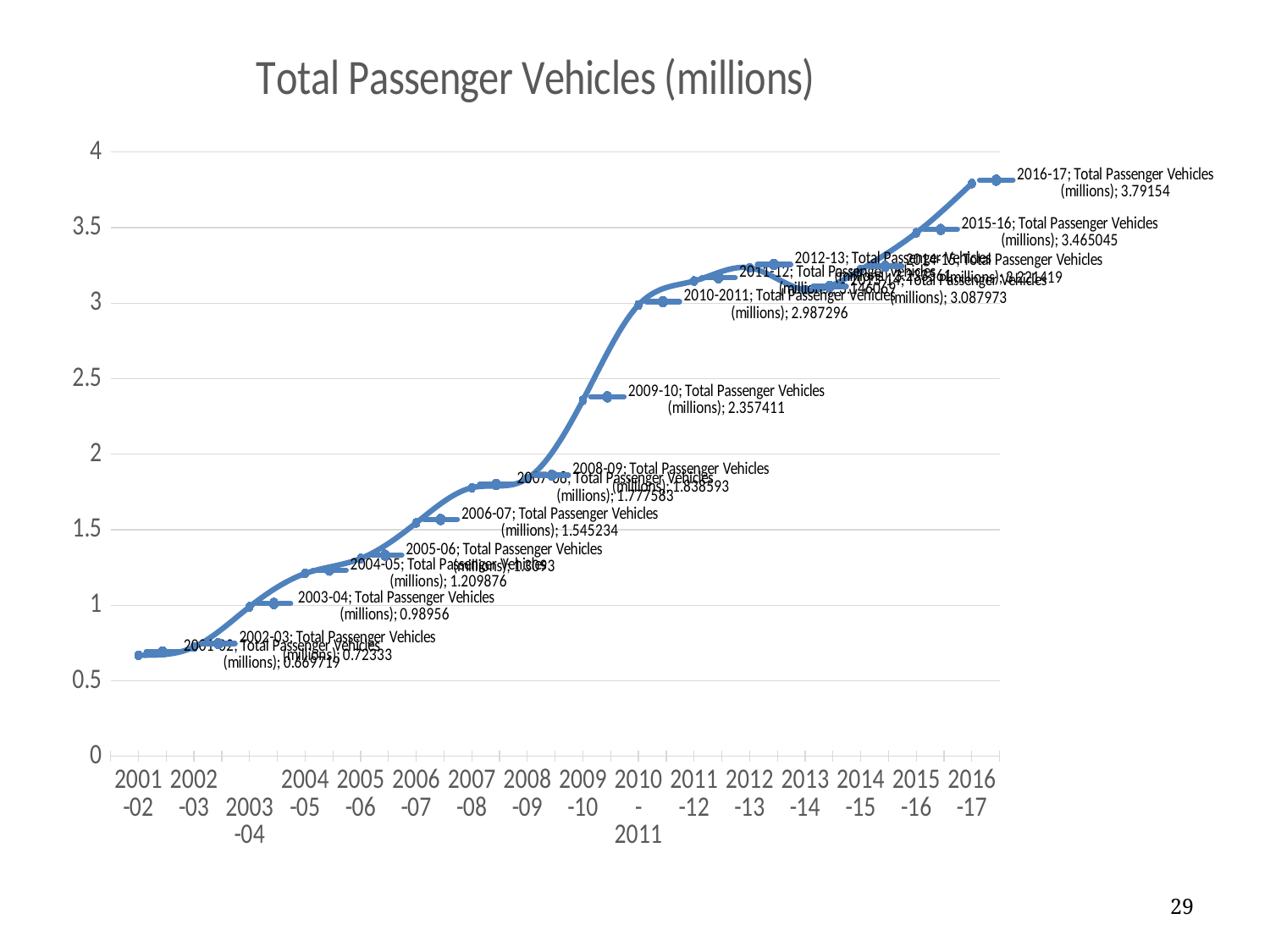
How many years are plotted on the x axis of the chart? 16 Which year has the lowest value in the chart? 2001-02 What kind of chart is shown on the slide? line chart What is the value for 2001-02 in the Total Passenger Vehicles (millions) chart? 0.669719 Is the value for 2010-2011 greater or less than 2.5? greater Which is larger, the value for 2009-10 or the value for 2008-09? 2009-10 What is the difference between the values for 2016-17 and 2015-16? 0.326495 What is the value for 2016-17 in the Total Passenger Vehicles (millions) chart? 3.79154 Do the values rise or fall from 2001-02 to 2016-17? rise Which year has the highest value in the chart? 2016-17 What is the value for 2009-10 in the Total Passenger Vehicles (millions) chart? 2.357411 What is the value for 2003-04 in the Total Passenger Vehicles (millions) chart? 0.98956